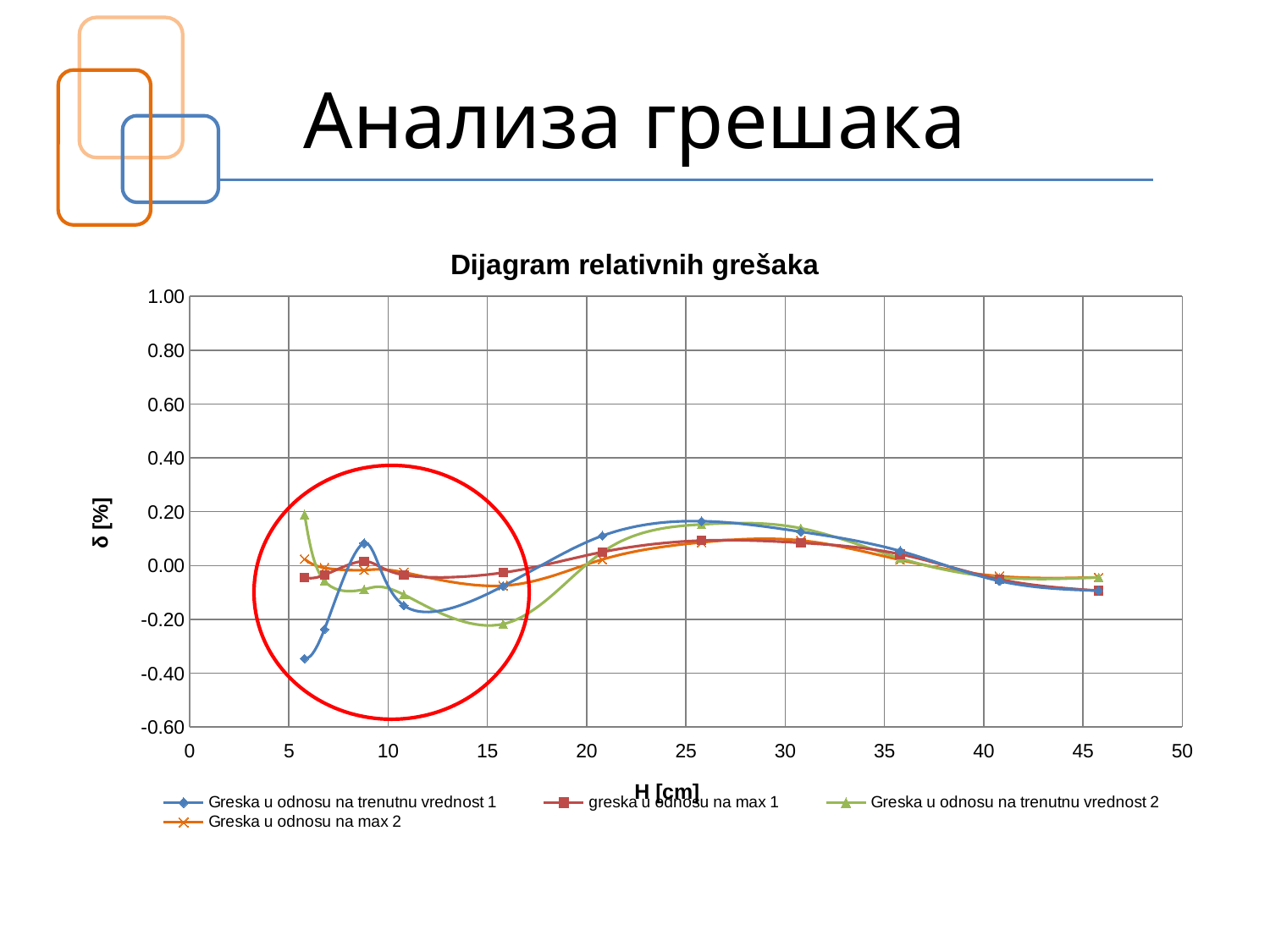
Is the value of the series 'Greska u odnosu na trenutnu vrednost 1' at H about 46 cm greater or less than 0.00? less What is the label of the x axis of the chart? H [cm] How many series does the legend of the chart list? 4 Is the value of the series 'Greska u odnosu na trenutnu vrednost 1' at H about 26 cm greater or less than 0.00? greater What is the highest tick value shown on the y axis of the chart? 1.00 At H about 6 cm, which series has the larger value: 'Greska u odnosu na trenutnu vrednost 1' or 'Greska u odnosu na trenutnu vrednost 2'? Greska u odnosu na trenutnu vrednost 2 Which series contains the lowest plotted value on the chart? Greska u odnosu na trenutnu vrednost 1 Is the value of the series 'Greska u odnosu na trenutnu vrednost 1' at its first point (H about 6 cm) greater or less than -0.20? less What kind of chart is shown on the slide? line chart Does the series 'Greska u odnosu na trenutnu vrednost 1' rise or fall between H about 26 cm and H about 46 cm? fall What is the title of the chart? Dijagram relativnih grešaka